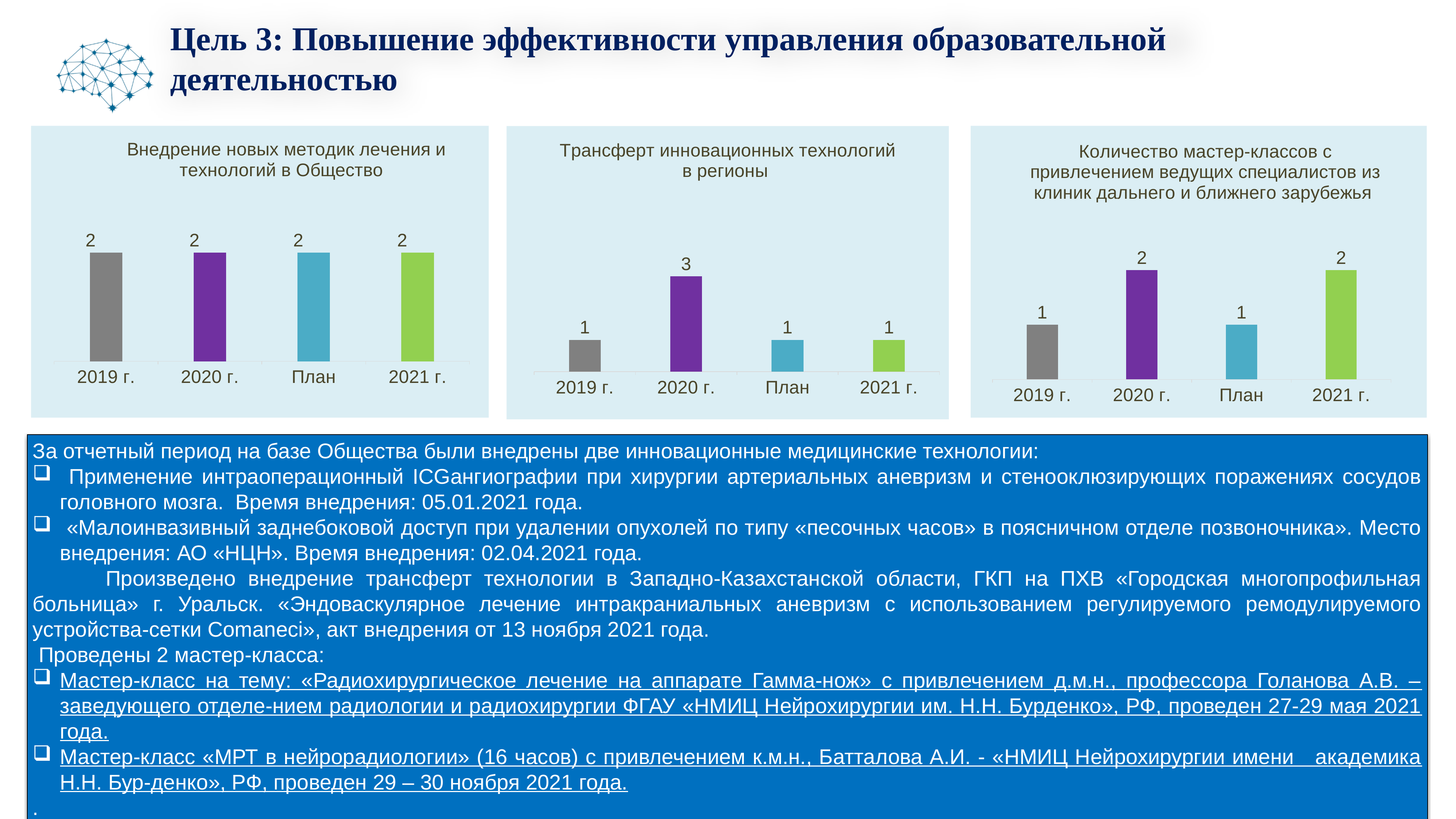
In the rightmost chart, which is larger: the value for 2021 г. or the value for План? 2021 г. In the chart 'Внедрение новых методик лечения и технологий в Общество', how many categories are shown on the x axis? 4 In the chart 'Количество мастер-классов с привлечением ведущих специалистов из клиник дальнего и ближнего зарубежья', what is the value for 2019 г.? 1 What type of chart is the middle chart on the slide? Bar chart In the chart 'Трансферт инновационных технологий в регионы', what is the value for План? 1 In the rightmost chart, what is the difference between the values for 2020 г. and План? 1 What is the title of the leftmost chart on the slide? Внедрение новых методик лечения и технологий в Общество In the chart 'Внедрение новых методик лечения и технологий в Общество', what is the value for План? 2 In the chart 'Трансферт инновационных технологий в регионы', which category has the highest value? 2020 г. In the chart 'Трансферт инновационных технологий в регионы', what is the difference between the values for 2020 г. and 2021 г.? 2 In the chart 'Количество мастер-классов с привлечением ведущих специалистов из клиник дальнего и ближнего зарубежья', what is the value for 2021 г.? 2 In the chart 'Трансферт инновационных технологий в регионы', what is the value for 2020 г.? 3